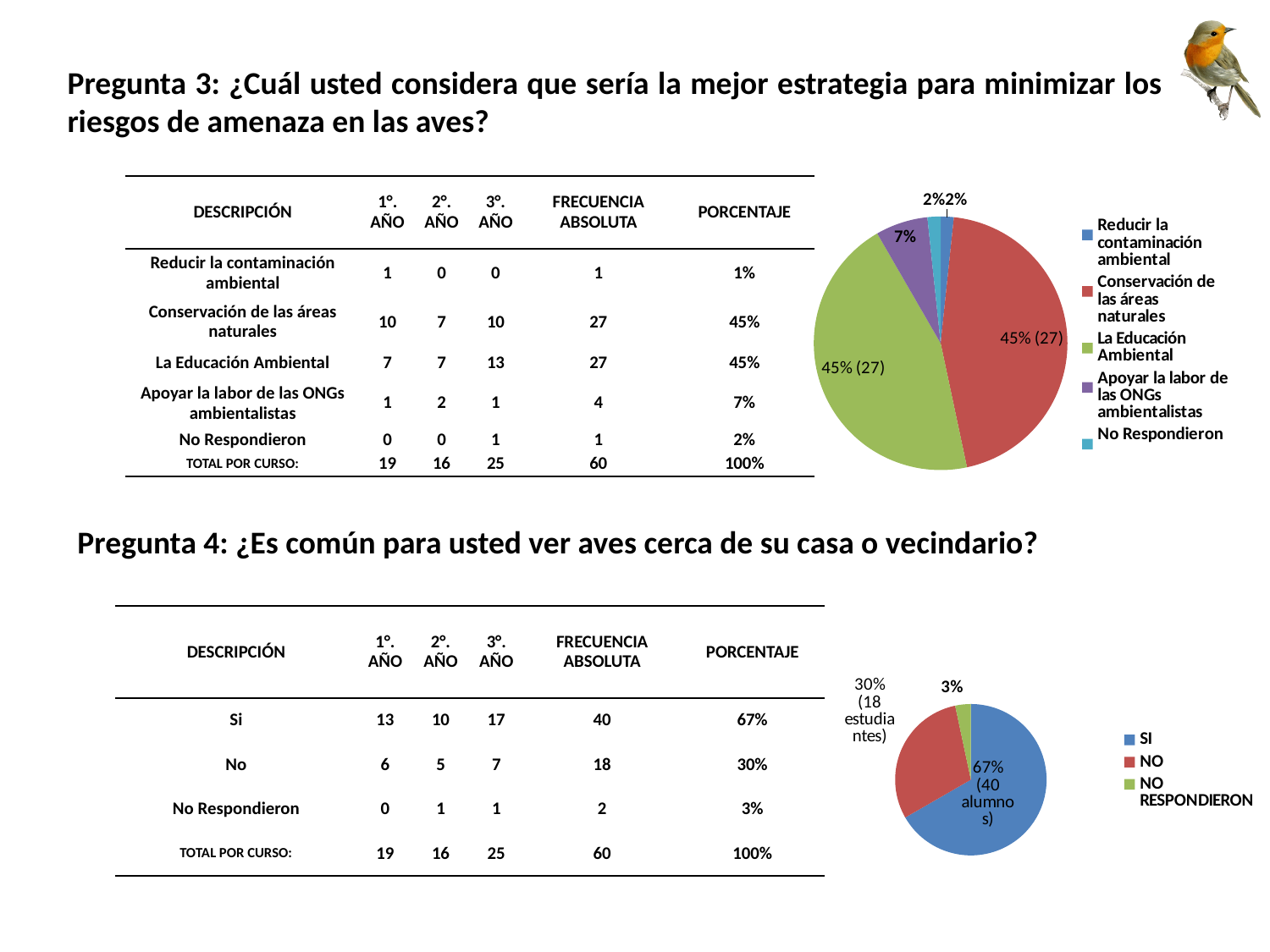
On the Pregunta 4 chart, what is the difference in percentage points between SI and NO? 37% On the Pregunta 4 chart, what percentage is shown for NO? 30% On the Pregunta 3 chart, what percentage is shown for Apoyar la labor de las ONGs ambientalistas? 7% On the Pregunta 4 chart, what percentage is shown for SI? 67% On the Pregunta 3 chart, what kind of chart is shown? pie chart On the Pregunta 3 chart, how many entries does the legend list? 5 On the Pregunta 3 chart, what label is shown for the La Educación Ambiental slice? 45% (27) On the Pregunta 4 chart, which category has the largest slice? SI On the Pregunta 4 chart, what percentage is shown for NO RESPONDIERON? 3% On the Pregunta 4 chart, what kind of chart is shown? pie chart On the Pregunta 3 chart, which slice is larger: Conservación de las áreas naturales or Apoyar la labor de las ONGs ambientalistas? Conservación de las áreas naturales On the Pregunta 4 chart, which category has the smallest slice? NO RESPONDIERON